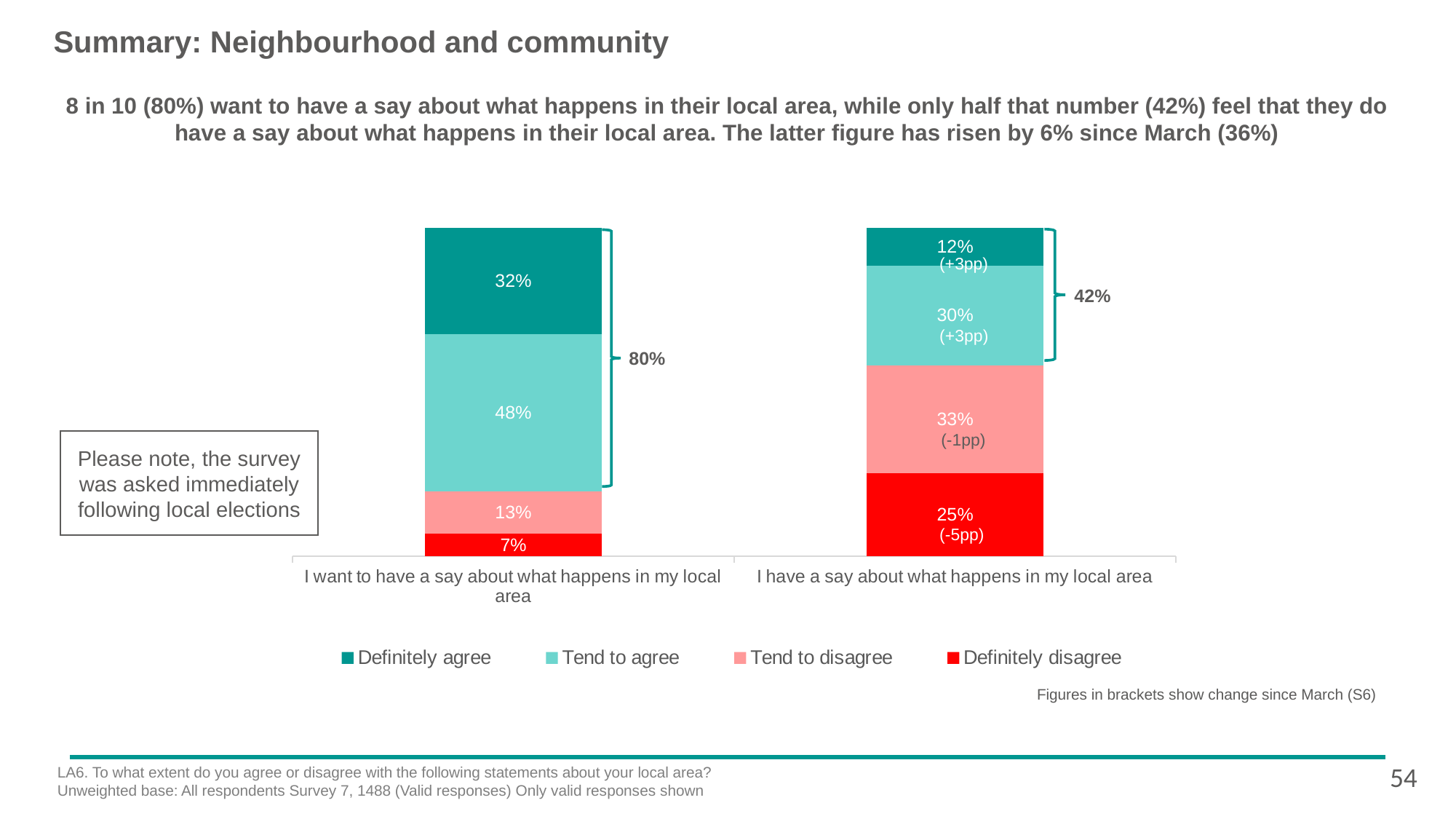
What percentage of respondents 'Tend to disagree' with 'I want to have a say about what happens in my local area'? 13% What is the combined agreement (Definitely agree plus Tend to agree) shown for 'I want to have a say about what happens in my local area'? 80% How many series does the legend list? 4 What type of chart is shown on the slide? Stacked bar chart Which response category is the largest for 'I want to have a say about what happens in my local area'? Tend to agree What is the difference between the 'Tend to agree' values for the two statements? 18 percentage points Which response category is the smallest for 'I have a say about what happens in my local area'? Definitely agree What is the combined agreement (Definitely agree plus Tend to agree) shown for 'I have a say about what happens in my local area'? 42% What percentage of respondents 'Tend to agree' with 'I have a say about what happens in my local area'? 30% What percentage of respondents 'Definitely disagree' with 'I have a say about what happens in my local area'? 25% What percentage of respondents 'Definitely agree' with 'I want to have a say about what happens in my local area'? 32% Which statement has the larger 'Definitely disagree' share? I have a say about what happens in my local area